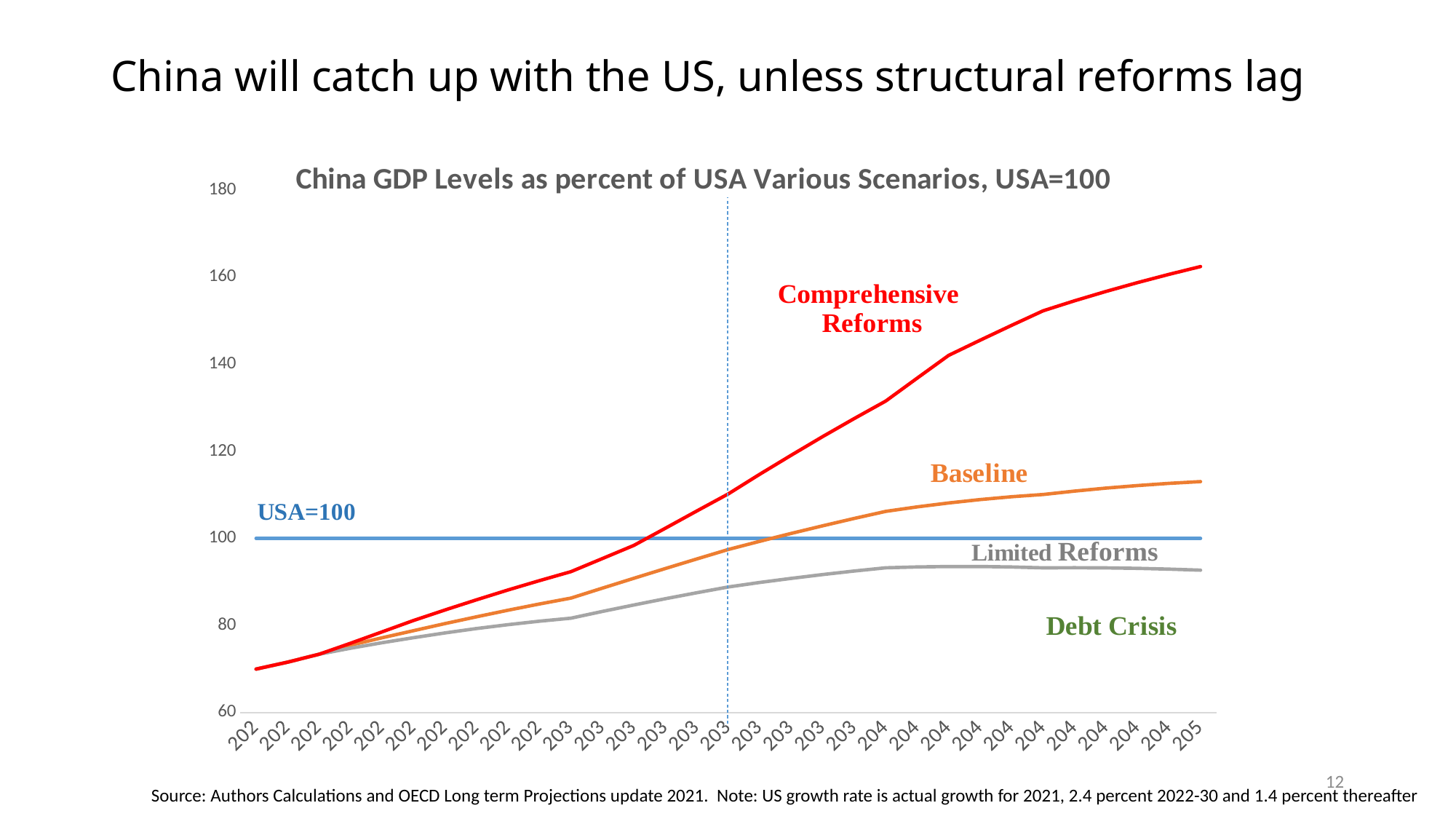
At the right end of the chart, which is higher, the Baseline line or the Limited Reforms line? Baseline Is the final value of the Baseline line greater or less than 120? less Does the Comprehensive Reforms line rise or fall along the x axis? rises What colour is the Comprehensive Reforms line? red What kind of chart is shown on the slide? line chart Which scenario line is lowest at the right end of the chart? Limited Reforms What value does the horizontal blue line labelled USA=100 represent? 100 Is the final value of the Comprehensive Reforms line greater or less than 140? greater What is the title of the chart? China GDP Levels as percent of USA Various Scenarios, USA=100 Does the Baseline line rise or fall along the x axis? rises Is the highest value reached by the Limited Reforms line greater or less than 100? less Which scenario line is highest at the right end of the chart? Comprehensive Reforms